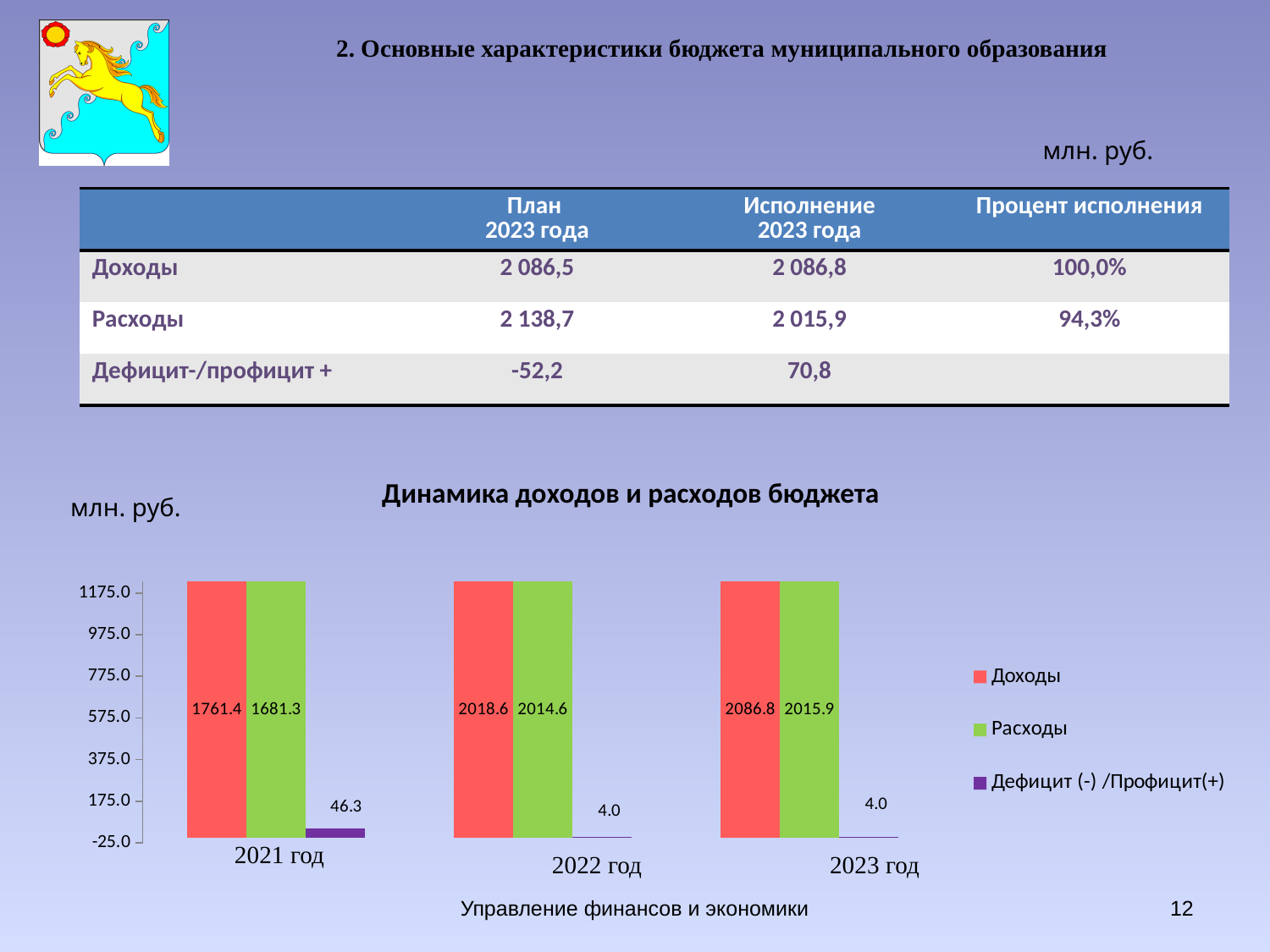
In the chart 'Динамика доходов и расходов бюджета', what is the value of Доходы for 2023 год? 2086.8 In the chart 'Динамика доходов и расходов бюджета', which year has the highest Доходы value? 2023 год How many series does the legend of the chart 'Динамика доходов и расходов бюджета' list? 3 In the chart 'Динамика доходов и расходов бюджета', what is the value of Дефицит (-) /Профицит(+) for 2021 год? 46.3 In the chart 'Динамика доходов и расходов бюджета', what is the value of Расходы for 2022 год? 2014.6 In the chart 'Динамика доходов и расходов бюджета', which year has the lowest Расходы value? 2021 год How many year categories are shown on the x axis of the chart 'Динамика доходов и расходов бюджета'? 3 In the chart 'Динамика доходов и расходов бюджета', which is larger for 2021 год: Доходы or Расходы? Доходы In the chart 'Динамика доходов и расходов бюджета', what is the difference between Доходы and Расходы for 2023 год? 70.9 In the chart 'Динамика доходов и расходов бюджета', what is the value of Доходы for 2021 год? 1761.4 In the chart 'Динамика доходов и расходов бюджета', do the Доходы values rise or fall from 2021 год to 2023 год? rise What type of chart is 'Динамика доходов и расходов бюджета'? bar chart